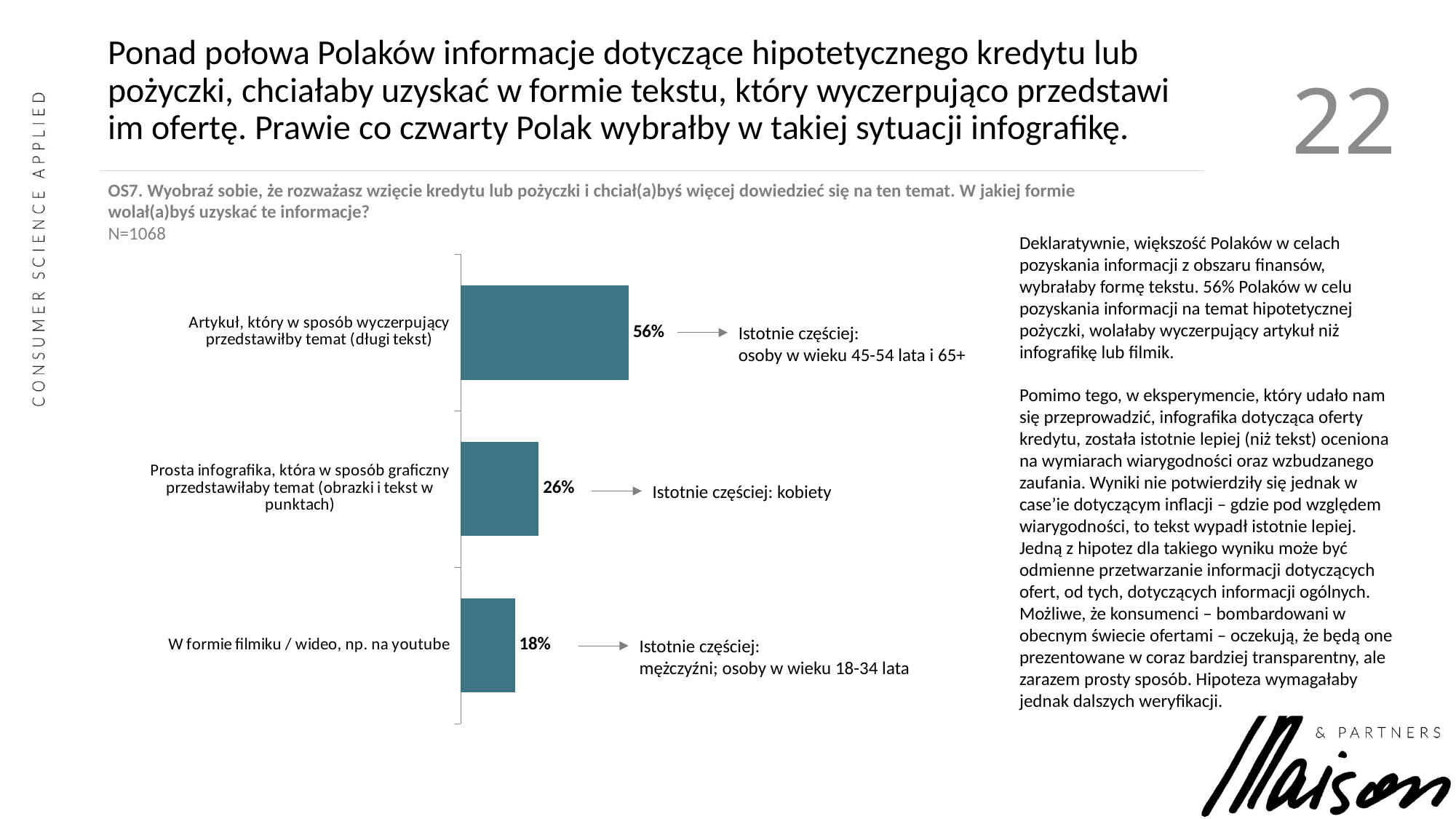
Which information format has the lowest share of respondents? W formie filmiku / wideo, np. na youtube What percentage of respondents chose the long-text article option (Artykuł, który w sposób wyczerpujący przedstawiłby temat)? 56% What percentage of respondents chose the simple infographic option (Prosta infografika)? 26% How many information formats (categories) are shown in the chart? 3 What is the sample size (N) stated for the chart? N=1068 What type of chart is shown on the slide? Bar chart What percentage of respondents chose the video option (W formie filmiku / wideo, np. na youtube)? 18% Which has a larger share: the simple infographic or the video format? Prosta infografika What is the difference in percentage points between the long-text article and the simple infographic? 30 Which information format has the highest share of respondents? Artykuł, który w sposób wyczerpujący przedstawiłby temat (długi tekst) What is the difference in percentage points between the simple infographic and the video option? 8 According to the annotation next to the 26% bar, which group chose the infographic significantly more often? Kobiety